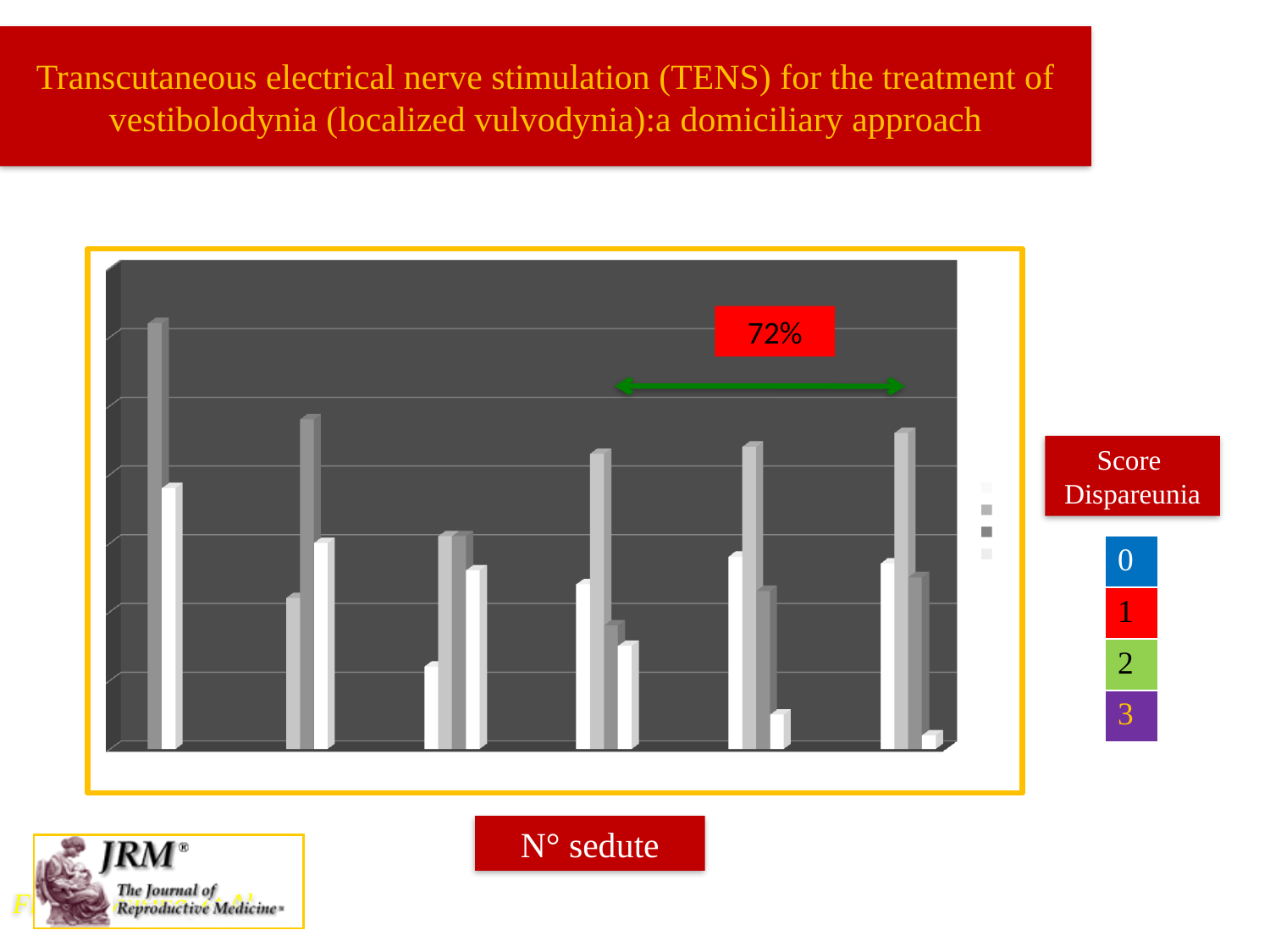
How many score levels are listed in the Score Dispareunia key next to the chart? 4 How many groups of bars are plotted along the x axis of the chart? 6 What label is shown beneath the chart for the x axis? N° sedute Counting from the left, in which group of bars does the tallest bar of the whole chart appear? the first group What kind of chart is shown on the slide? bar chart What percentage is printed in the red box above the chart? 72%